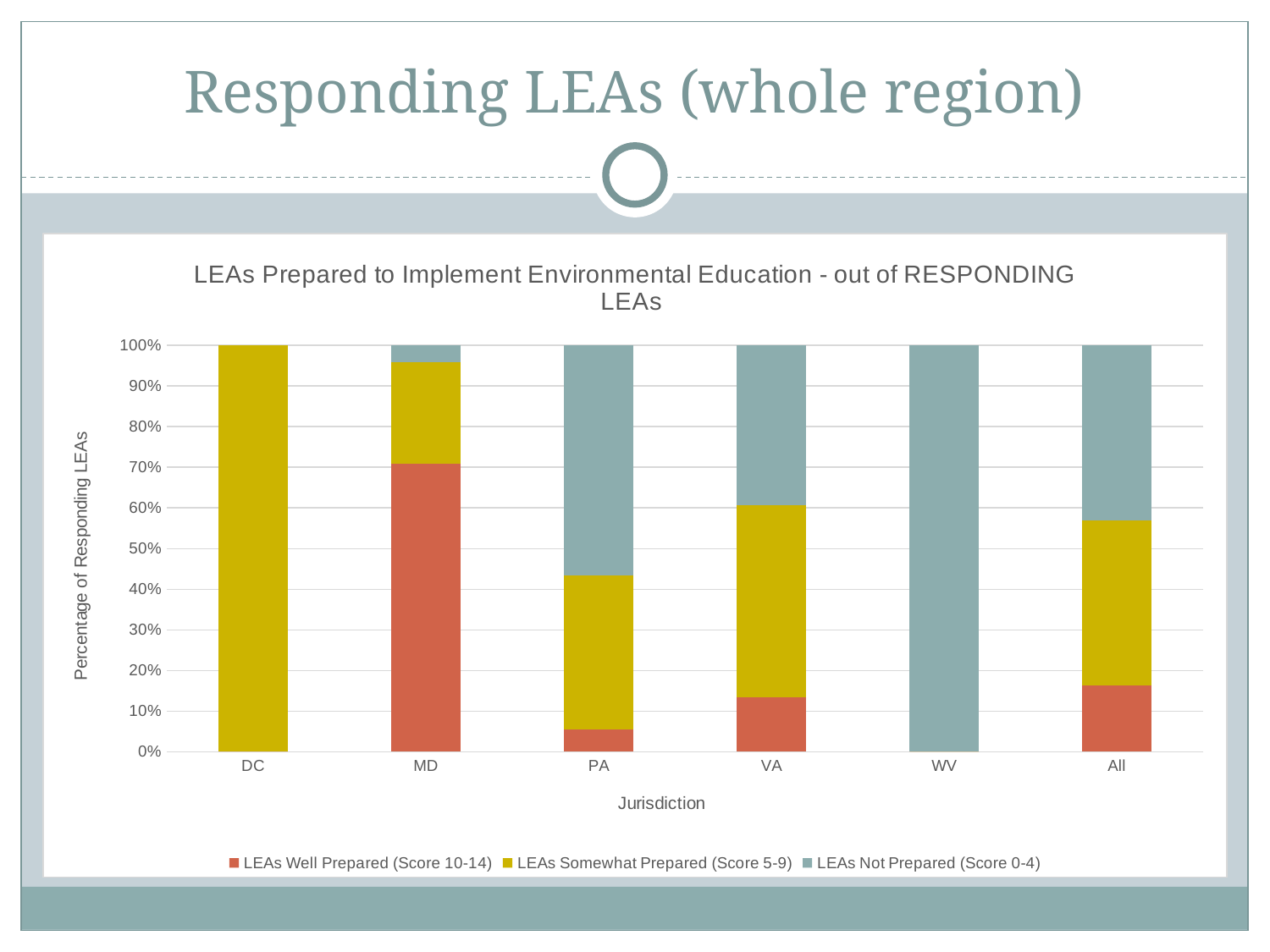
What is the label of the x axis? Jurisdiction Is the share of LEAs Well Prepared (Score 10-14) in MD greater or less than 60%? greater Which jurisdiction has the largest share of LEAs Well Prepared (Score 10-14)? MD What percentage of responding LEAs in WV are Not Prepared (Score 0-4)? 100% How many series does the chart's legend list? 3 What kind of chart is shown on the slide? bar chart What percentage of responding LEAs in DC are Somewhat Prepared (Score 5-9)? 100% Is the share of LEAs Well Prepared (Score 10-14) for All greater or less than 20%? less What is the title of the chart? LEAs Prepared to Implement Environmental Education - out of RESPONDING LEAs How many jurisdictions are shown on the x axis of the chart? 6 Is the share of LEAs Well Prepared (Score 10-14) in PA greater or less than 10%? less Which has a larger share of LEAs Well Prepared (Score 10-14), PA or VA? VA